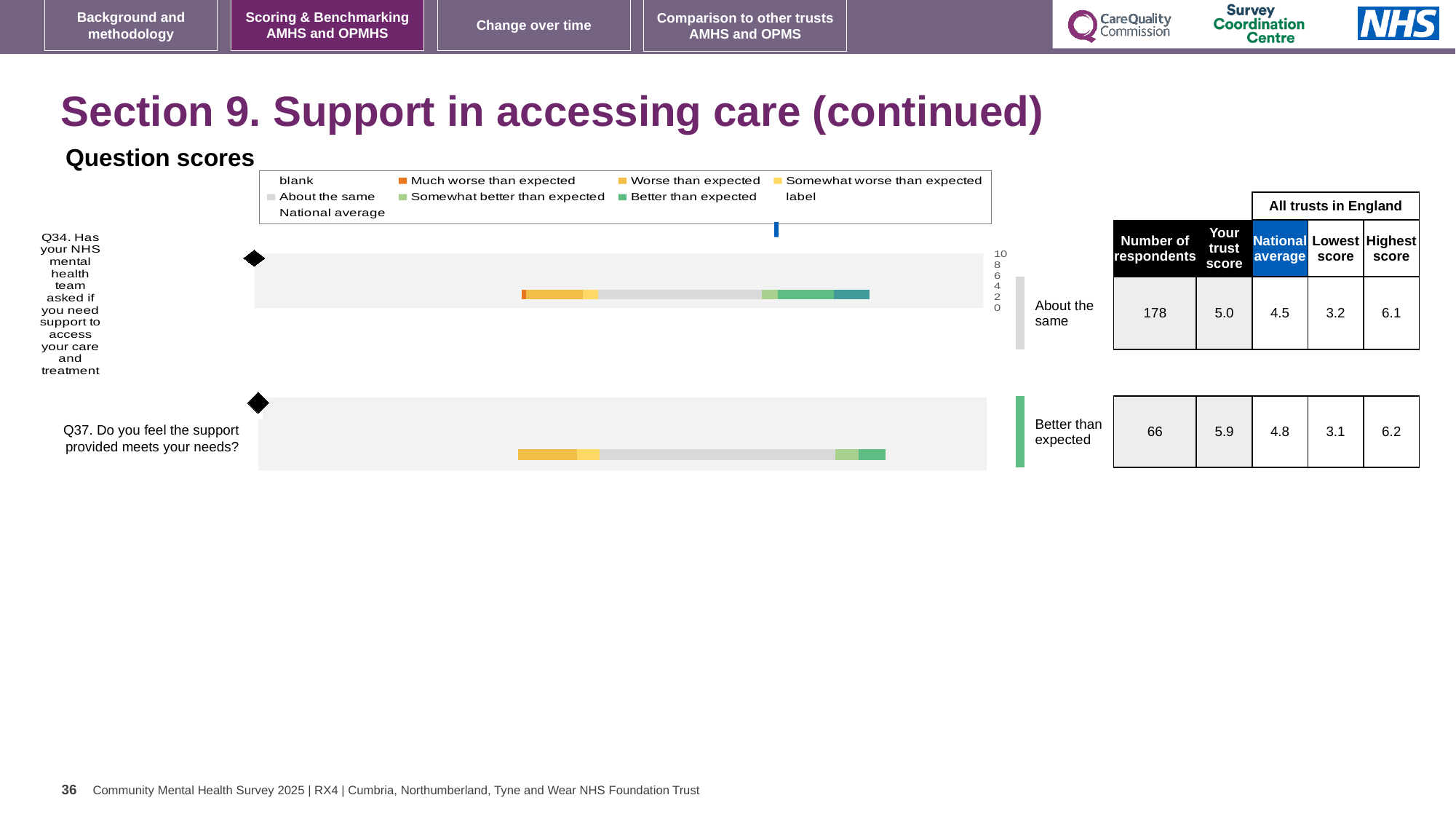
What is the 'Your trust score' for Q37 (Do you feel the support provided meets your needs)? 5.9 How many questions are plotted in the question scores chart? 2 Which question in the chart is labelled 'About the same'? Q34 What is the highest score among all trusts in England for Q37? 6.2 What is the 'Your trust score' for Q34 (Has your NHS mental health team asked if you need support to access your care and treatment)? 5.0 Which question had more respondents, Q34 or Q37? Q34 What is the difference between the highest score and the lowest score for Q34? 2.9 For Q37, which is larger: the trust score or the national average? the trust score (5.9) Which question in the chart is labelled 'Better than expected'? Q37 What is the national average score for Q34? 4.5 How many respondents answered Q37? 66 What kind of chart is used to show the question scores for Q34 and Q37? bar chart